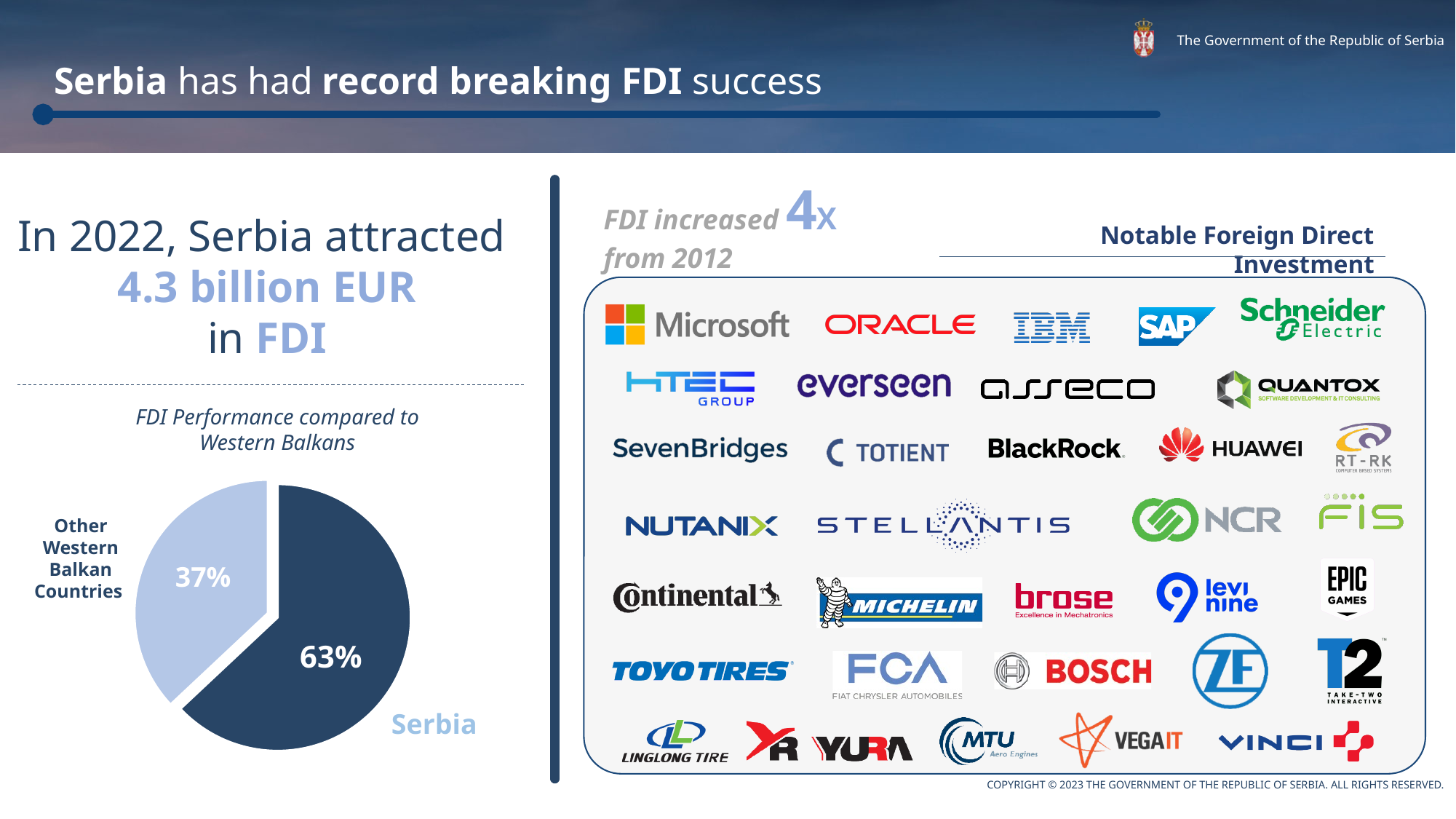
Which slice of the pie chart is the smallest? Other Western Balkan Countries Which is larger in the pie chart: Serbia or Other Western Balkan Countries? Serbia Is the share for Serbia in the pie chart greater or less than 50%? greater Which slice of the pie chart is the largest? Serbia What colour is the Serbia slice in the pie chart? dark blue What share of the pie chart does Serbia account for? 63% What kind of chart is shown under the heading 'FDI Performance compared to Western Balkans'? pie chart What share of the pie chart do Other Western Balkan Countries account for? 37% How many slices does the pie chart have? 2 What is the difference in percentage points between the Serbia slice and the Other Western Balkan Countries slice? 26 percentage points What is the title of the pie chart? FDI Performance compared to Western Balkans What is the total of the two slices shown in the pie chart? 100%